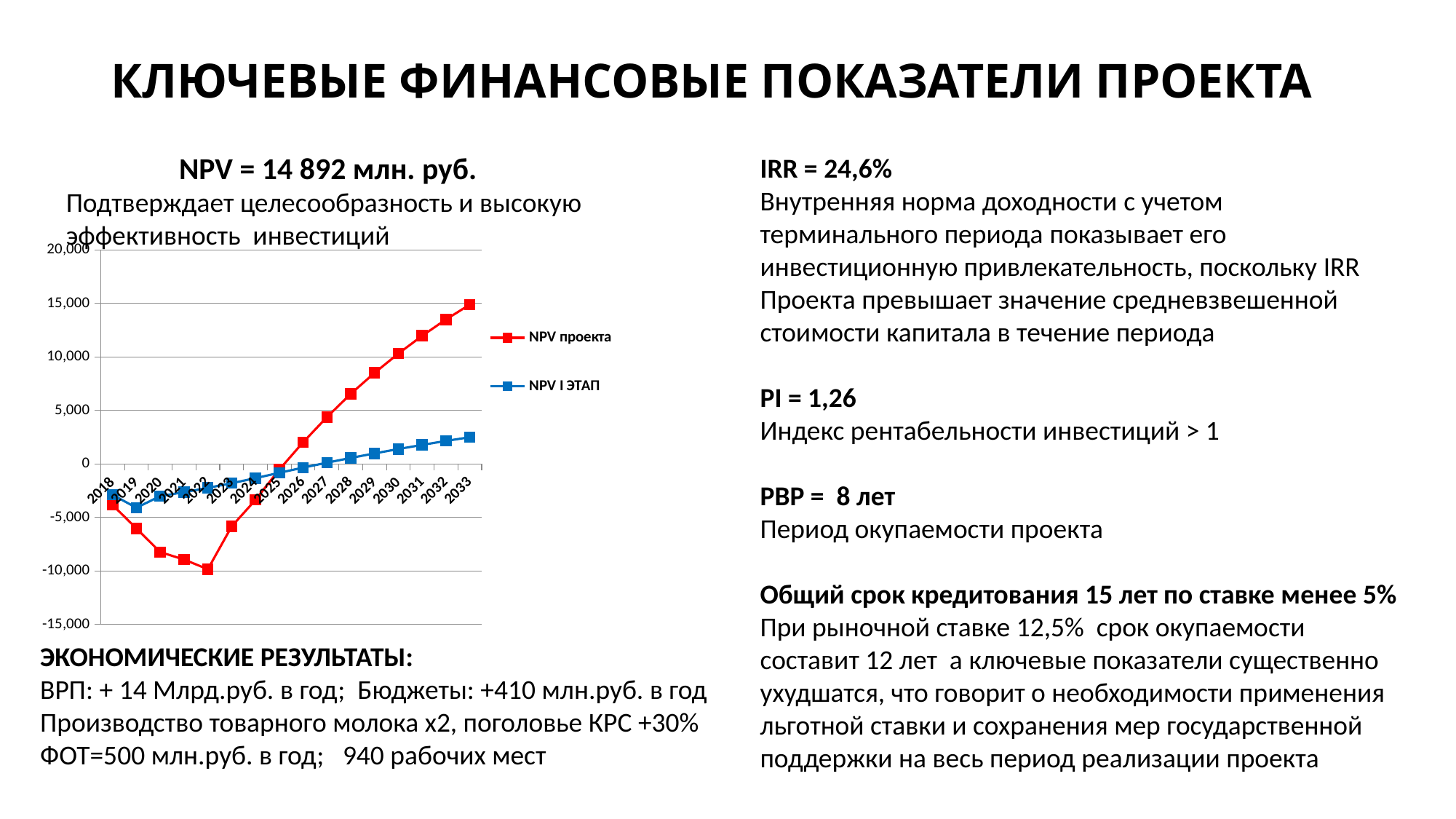
What are the two entries in the chart legend? NPV проекта and NPV I ЭТАП Is the value of NPV проекта in 2033 greater or less than 10,000? greater What kind of chart is shown on the slide? Line chart Does the NPV I ЭТАП series rise or fall from 2019 to 2033? rises In which year does the NPV проекта series reach its highest value? 2033 Is the value of NPV проекта in 2022 greater or less than -5,000? less How many years are plotted along the x axis of the chart? 16 In 2020, which series has the larger value: NPV проекта or NPV I ЭТАП? NPV I ЭТАП In which year does the NPV проекта series reach its lowest value? 2022 How many series does the chart legend list? 2 In 2033, which series has the larger value: NPV проекта or NPV I ЭТАП? NPV проекта Is the value of NPV I ЭТАП in 2033 greater or less than 5,000? less